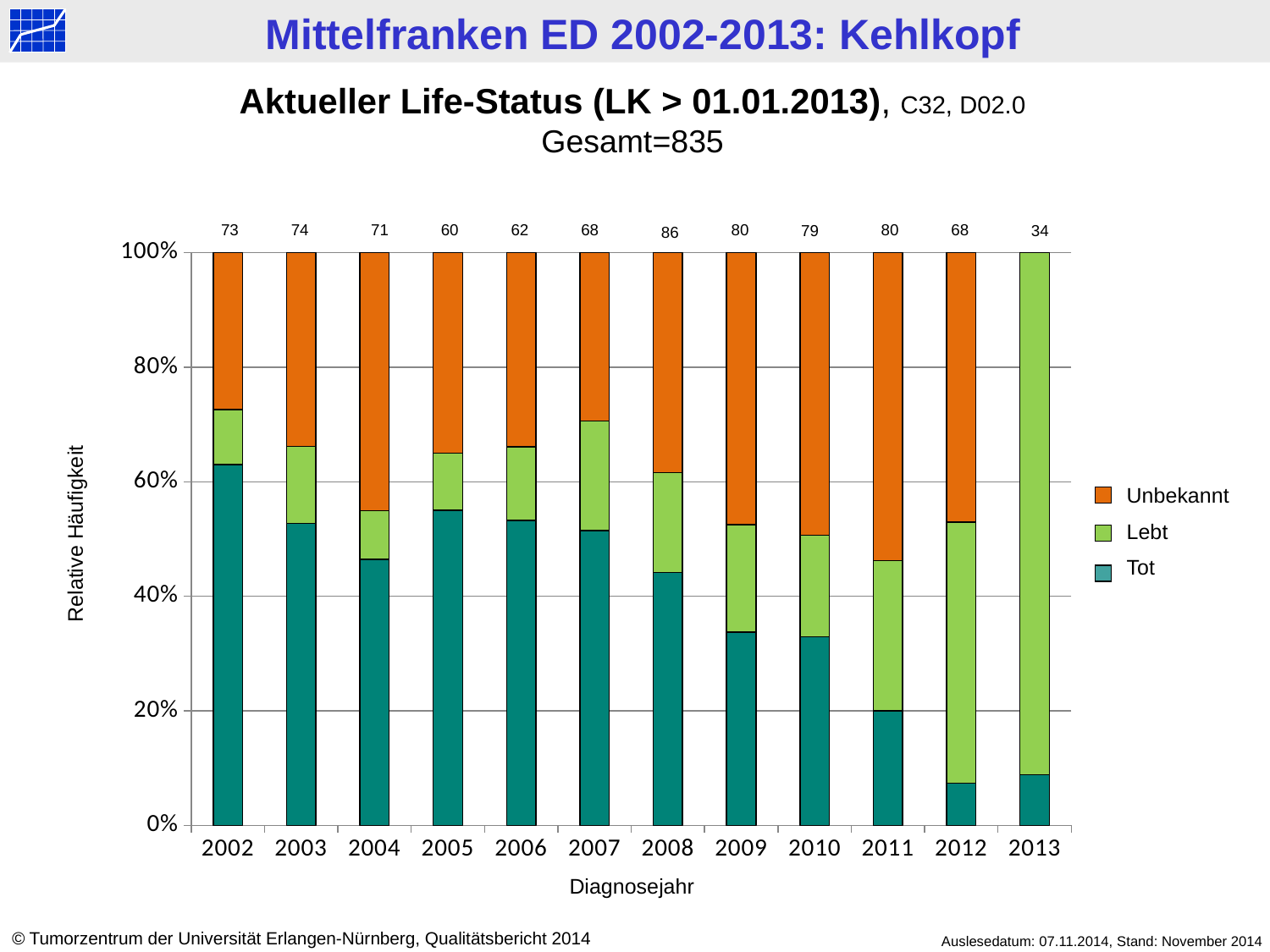
What is the number printed above the bar for 2013? 34 What kind of chart is shown on the slide? Stacked bar chart Which diagnosis year has the highest number printed above its bar? 2008 What is the difference between the numbers printed above the bars for 2008 and 2013? 52 Which year has the larger number printed above its bar, 2004 or 2012? 2004 How many series does the legend list? 3 Which diagnosis year has the lowest number printed above its bar? 2013 Is the share of 'Tot' in 2012 greater or less than 20%? less What is the number printed above the bar for 2005? 60 Is the share of 'Tot' in 2002 greater or less than 60%? greater How many diagnosis years are shown on the x axis? 12 What is the number printed above the bar for 2008? 86